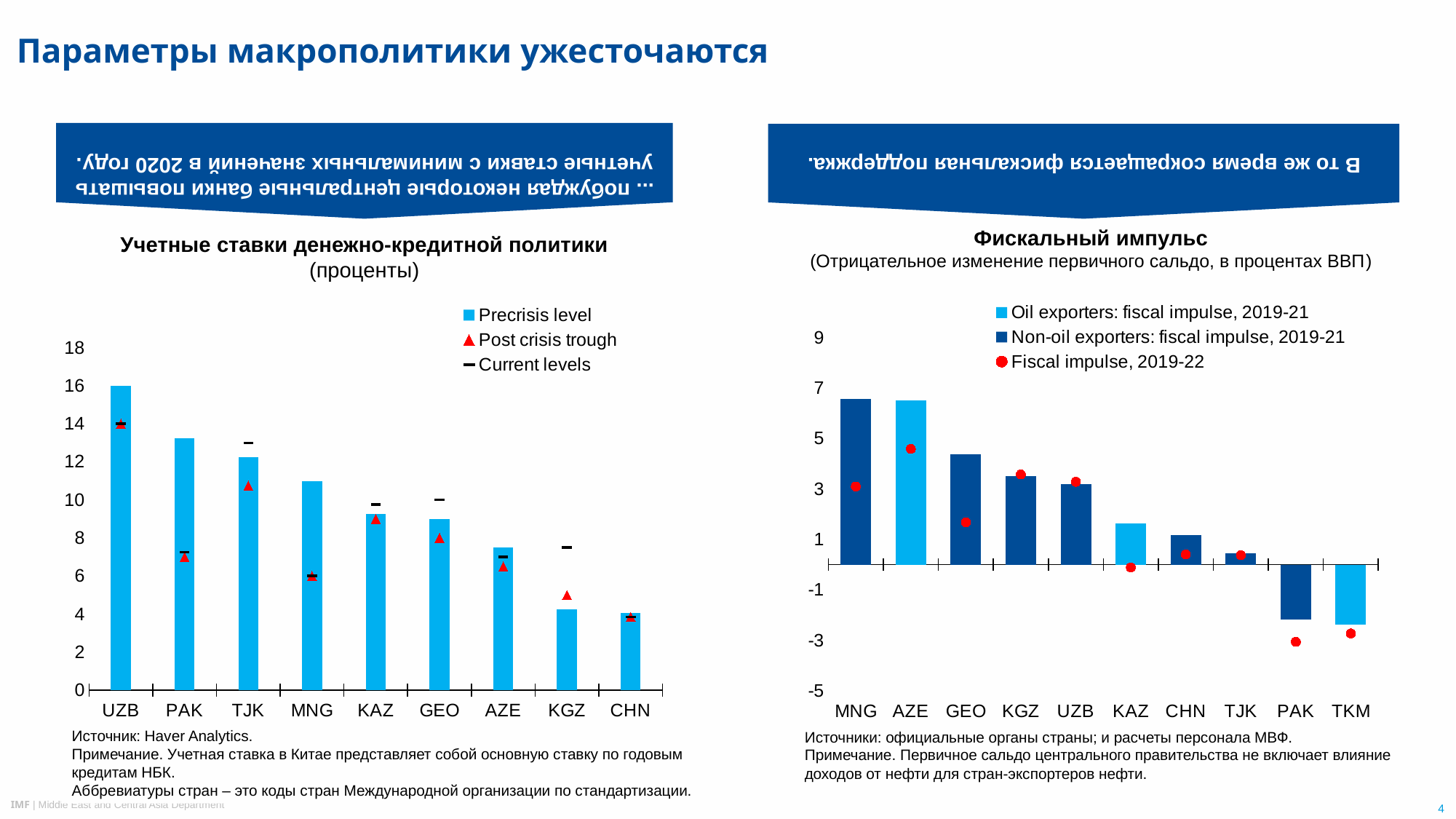
On the left chart (Учетные ставки денежно-кредитной политики), what kind of chart is used for the Precrisis level series? bar chart On the left chart (Учетные ставки денежно-кредитной политики), is the Precrisis level for PAK greater or less than 12? greater On the right chart (Фискальный импульс), how many countries are shown on the x axis? 10 On the left chart (Учетные ставки денежно-кредитной политики), how many countries are shown on the x axis? 9 On the left chart (Учетные ставки денежно-кредитной политики), how many series does the legend list? 3 On the left chart (Учетные ставки денежно-кредитной политики), is the Precrisis level for KGZ greater or less than 6? less On the right chart (Фискальный импульс), which country has the lowest bar? TKM On the right chart (Фискальный импульс), is the bar for GEO greater or less than 3? greater On the right chart (Фискальный импульс), how many series does the legend list? 3 On the left chart (Учетные ставки денежно-кредитной политики), which country has the highest Precrisis level bar? UZB On the left chart (Учетные ставки денежно-кредитной политики), which country has the lowest Precrisis level bar? CHN On the left chart (Учетные ставки денежно-кредитной политики), do the Precrisis level bars generally rise or fall from left to right? fall